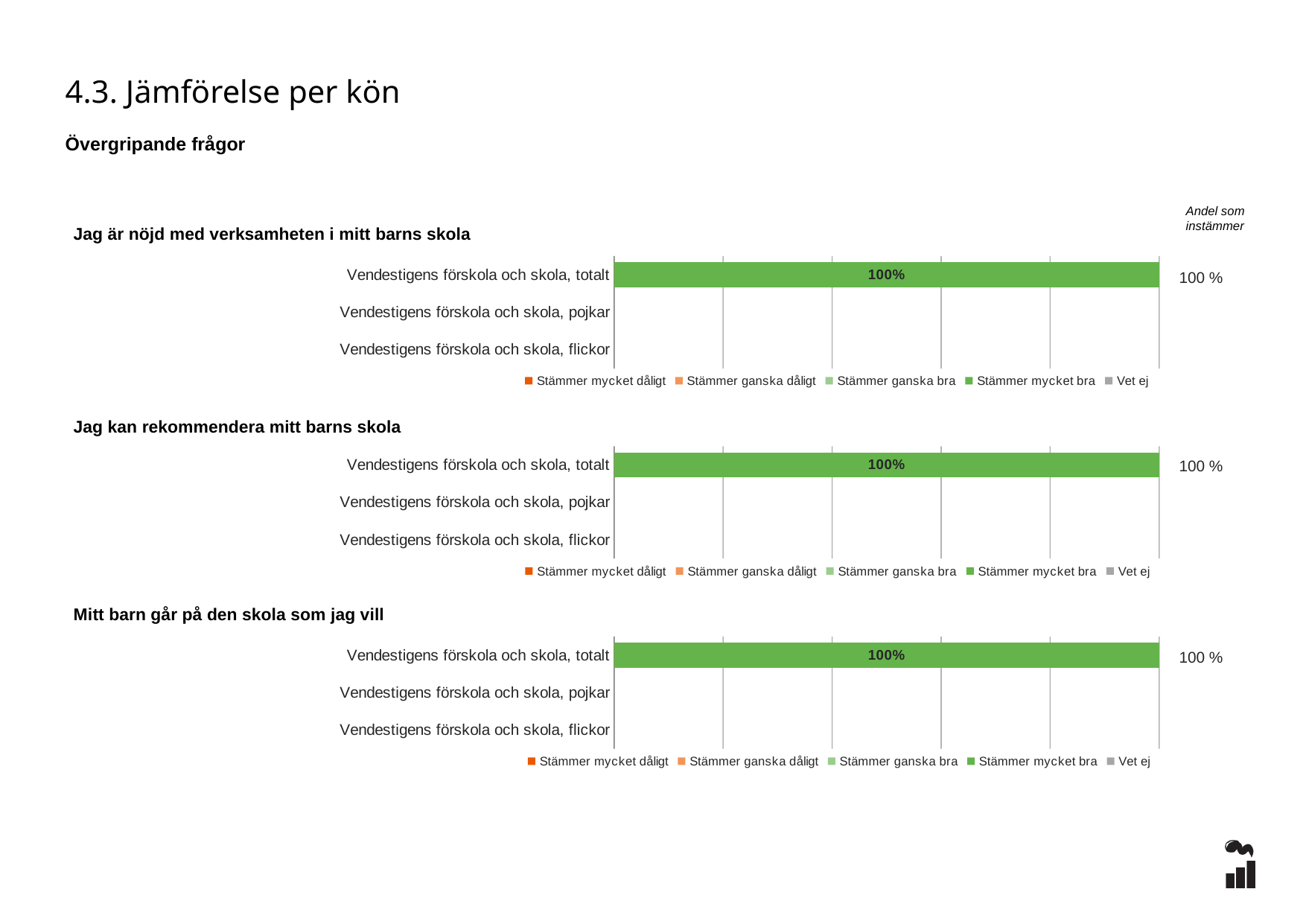
What is the last legend entry in the chart 'Mitt barn går på den skola som jag vill'? Vet ej In the chart 'Jag är nöjd med verksamheten i mitt barns skola', what is the data label on the bar for 'Vendestigens förskola och skola, totalt'? 100% What kind of chart is 'Mitt barn går på den skola som jag vill'? Bar chart How many series does the legend list in the chart 'Jag är nöjd med verksamheten i mitt barns skola'? 5 In the chart 'Jag kan rekommendera mitt barns skola', which category has the highest value? Vendestigens förskola och skola, totalt How many categories are shown on the y axis of the chart 'Jag kan rekommendera mitt barns skola'? 3 In the chart 'Jag är nöjd med verksamheten i mitt barns skola', which legend series does the bar for 'Vendestigens förskola och skola, totalt' belong to? Stämmer mycket bra How many charts are shown on the slide? 3 In the chart 'Mitt barn går på den skola som jag vill', what is the data label on the bar for 'Vendestigens förskola och skola, totalt'? 100% In the chart 'Mitt barn går på den skola som jag vill', is the value for 'Vendestigens förskola och skola, totalt' greater or less than 50%? greater In the chart 'Jag kan rekommendera mitt barns skola', what value is shown under 'Andel som instämmer' for 'Vendestigens förskola och skola, totalt'? 100 %